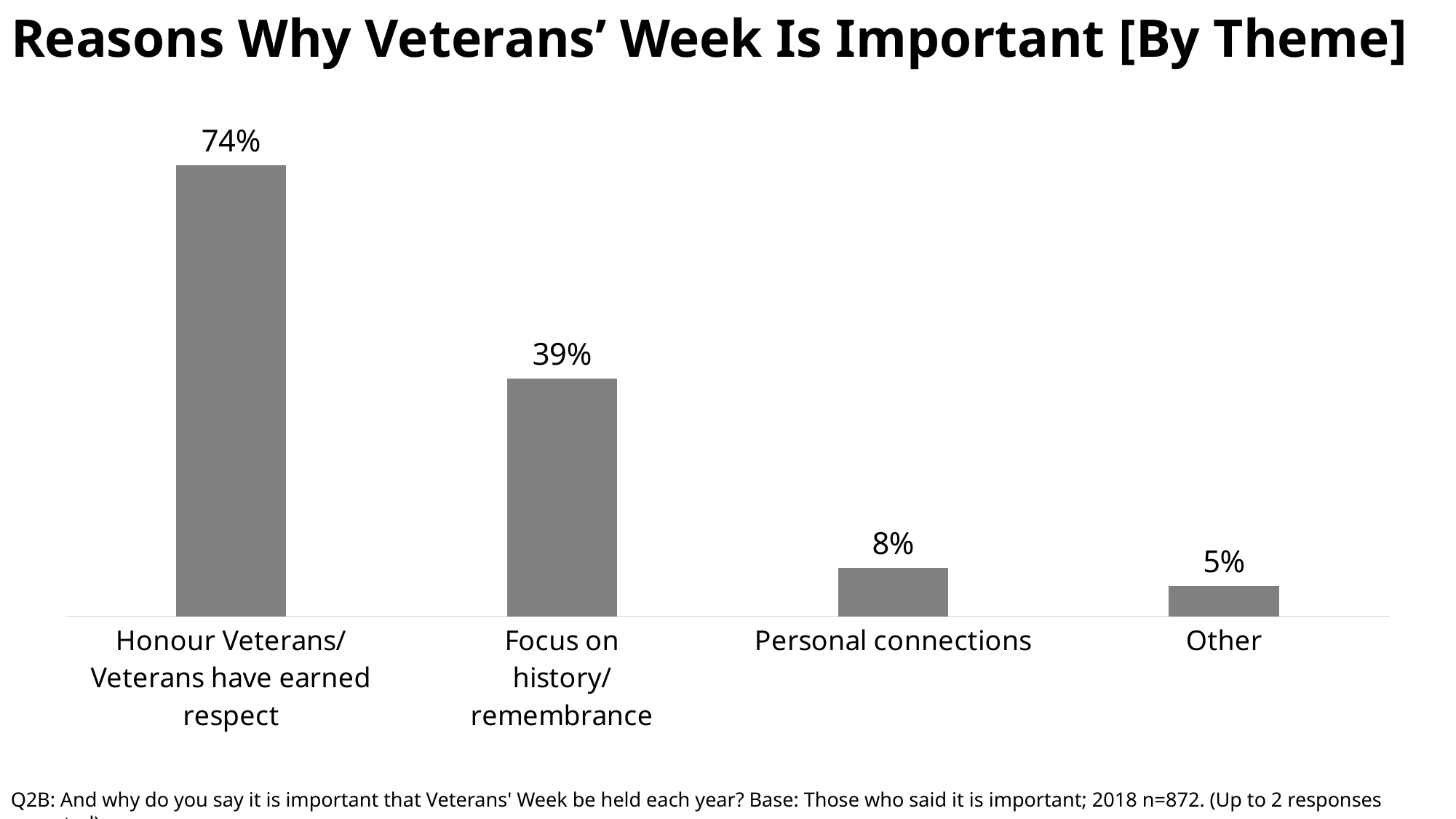
What is the title of the chart? Reasons Why Veterans' Week Is Important [By Theme] What is the value for "Other"? 5% What kind of chart is shown on the slide? Bar chart Which is larger: the value for "Focus on history/ remembrance" or the value for "Personal connections"? Focus on history/ remembrance Which category has the highest value? Honour Veterans/ Veterans have earned respect What is the value for "Focus on history/ remembrance"? 39% How many categories are shown in the chart? 4 Which category has the lowest value? Other What percentage is shown for "Honour Veterans/ Veterans have earned respect"? 74% What is the value for "Personal connections"? 8% What is the difference between the values for "Personal connections" and "Other"? 3% What is the difference between the values for "Honour Veterans/ Veterans have earned respect" and "Focus on history/ remembrance"? 35%